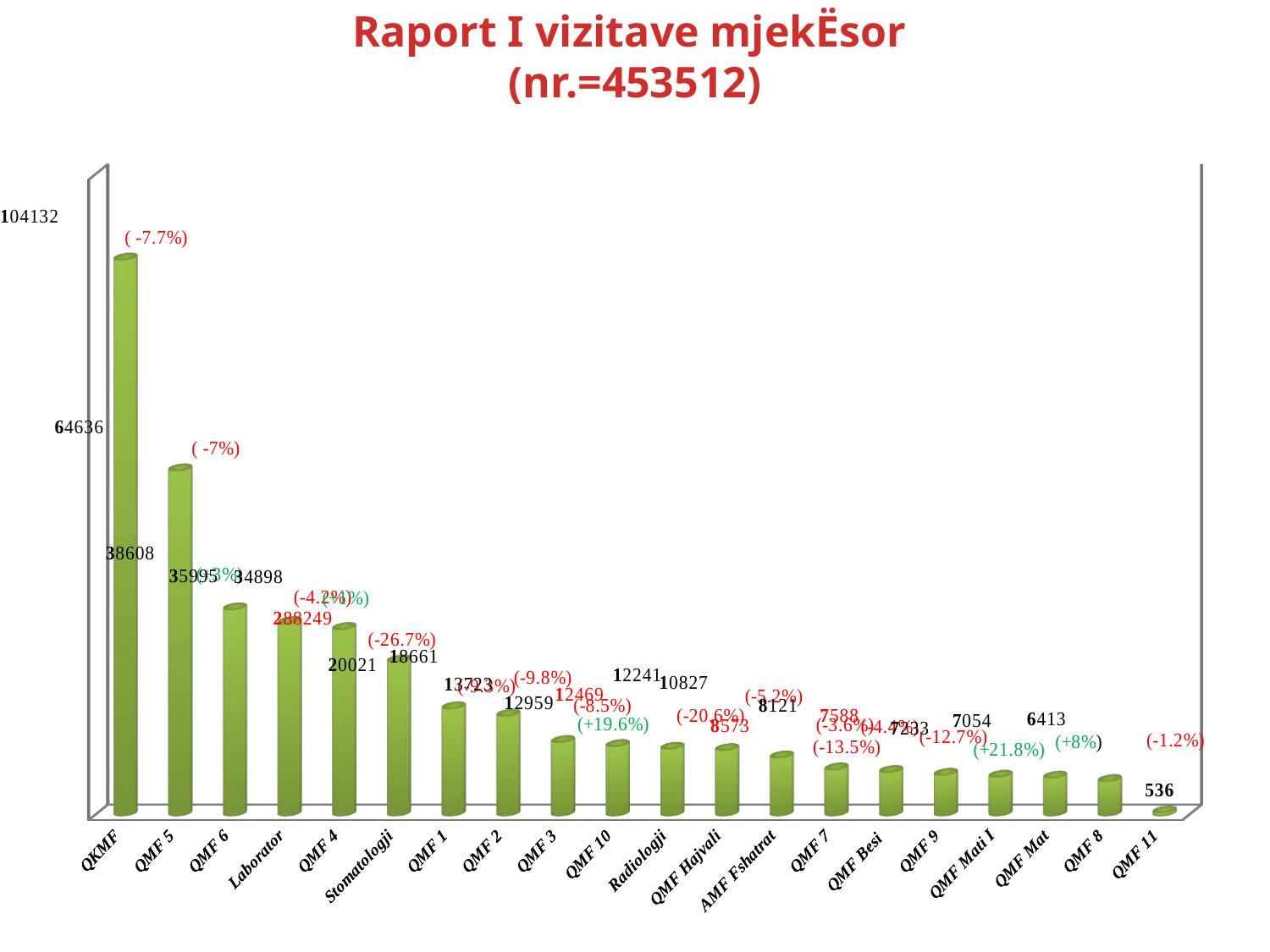
Do the values rise or fall moving from left to right along the x axis? fall What is the difference between the values for QKMF and QMF 5? 39496 Which is larger, the value for QKMF or the value for QMF 5? QKMF What is the value shown for QMF 5? 64636 What total number (nr.) is given in the chart title? 453512 What kind of chart is shown on the slide? bar chart How many categories are shown along the x axis of the chart? 20 Which category has the lowest value in the chart? QMF 11 Which is larger, the value for QMF 6 or the value for QMF 8? QMF 6 What is the value shown for QKMF? 104132 What is the value shown for QMF 11? 536 Which category has the highest value in the chart? QKMF